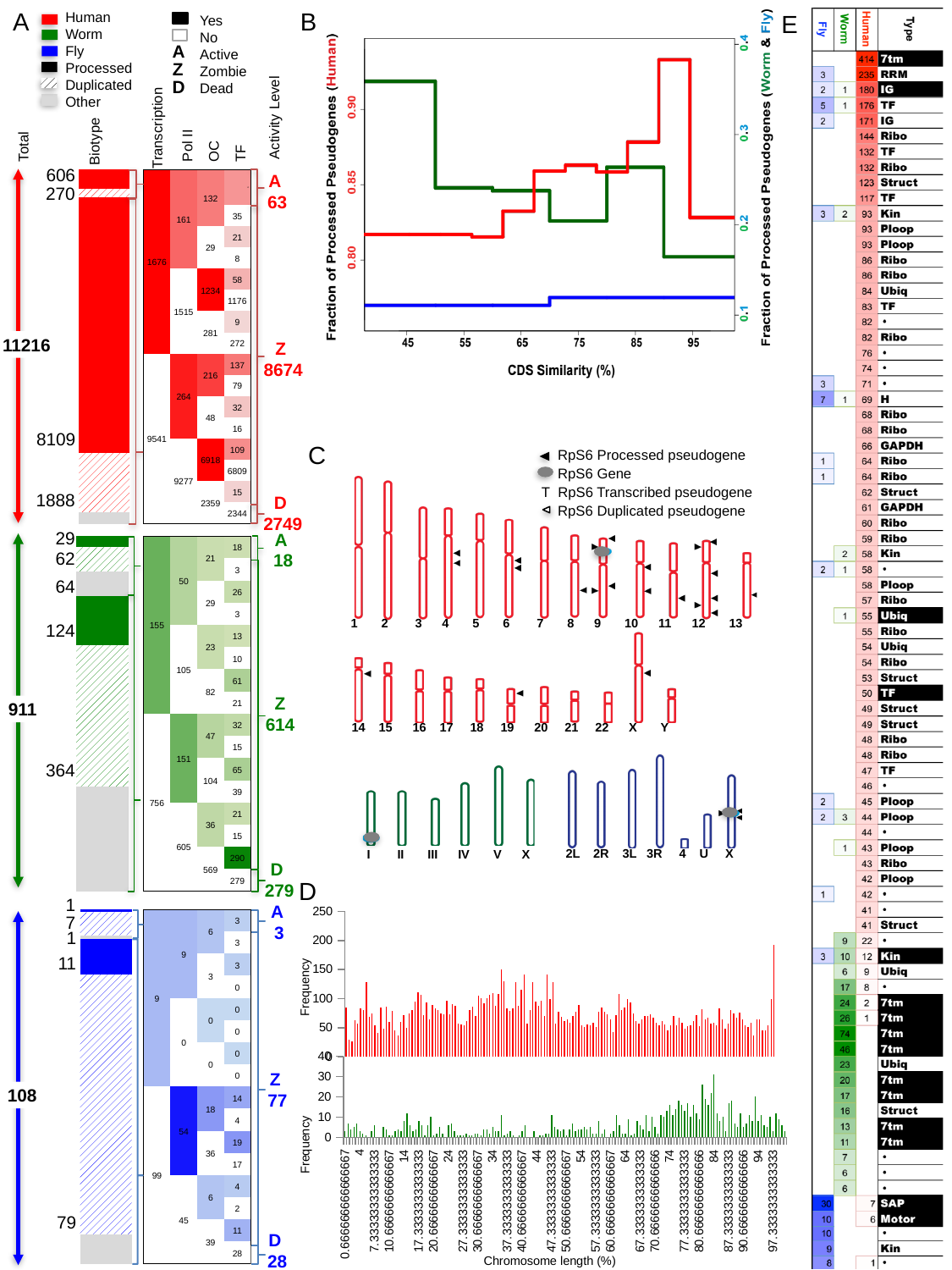
In panel A, how many Human pseudogenes are at the Zombie (Z) activity level? 8674 In panel A, what is the total number of pseudogenes shown for Fly? 108 What kind of chart is panel B? line chart What kind of chart is panel D? bar chart What is the x-axis label of the chart in panel B? CDS Similarity (%) In panel B, which of Worm or Fly has the lower fraction of processed pseudogenes across the CDS similarity range? Fly In panel A, what is the difference between the Human Zombie (Z) count and the Human Dead (D) count? 5925 In panel A, how many Fly pseudogenes are at the Active (A) activity level? 3 In panel A, what is the total number of pseudogenes shown for Human? 11216 In panel A, what is the total number of pseudogenes shown for Worm? 911 In panel A, which species has the highest total number of pseudogenes? Human In panel A, how many Worm pseudogenes are at the Dead (D) activity level? 279